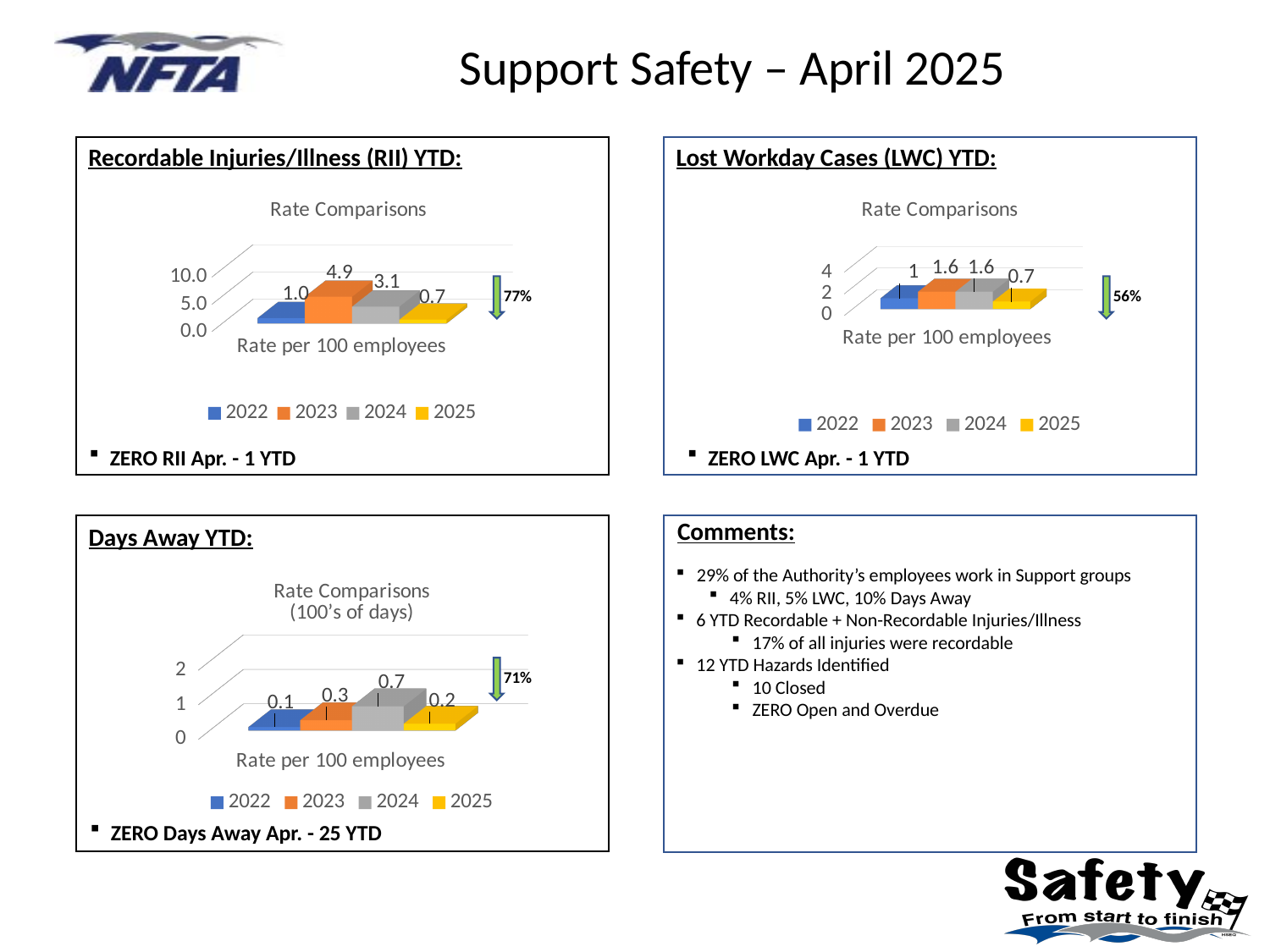
In the Recordable Injuries/Illness (RII) YTD chart, what is the difference between the 2023 and 2024 values? 1.8 In the Lost Workday Cases (LWC) YTD chart, what is the value for 2025? 0.7 What is the title of the chart in the Lost Workday Cases (LWC) YTD box? Rate Comparisons What type of chart is the Days Away YTD chart? bar chart In the Days Away YTD chart, what is the value for 2024? 0.7 In the Lost Workday Cases (LWC) YTD chart, which year has the lowest rate? 2025 In the Recordable Injuries/Illness (RII) YTD chart, how many series does the legend list? 4 In the Days Away YTD chart, which year has the highest rate? 2024 In the Lost Workday Cases (LWC) YTD chart, is the value for 2022 larger or smaller than the value for 2023? smaller In the Recordable Injuries/Illness (RII) YTD chart, which year has the highest rate? 2023 In the Recordable Injuries/Illness (RII) YTD chart, what is the value for 2023? 4.9 In the Days Away YTD chart, what is the difference between the 2024 and 2025 values? 0.5